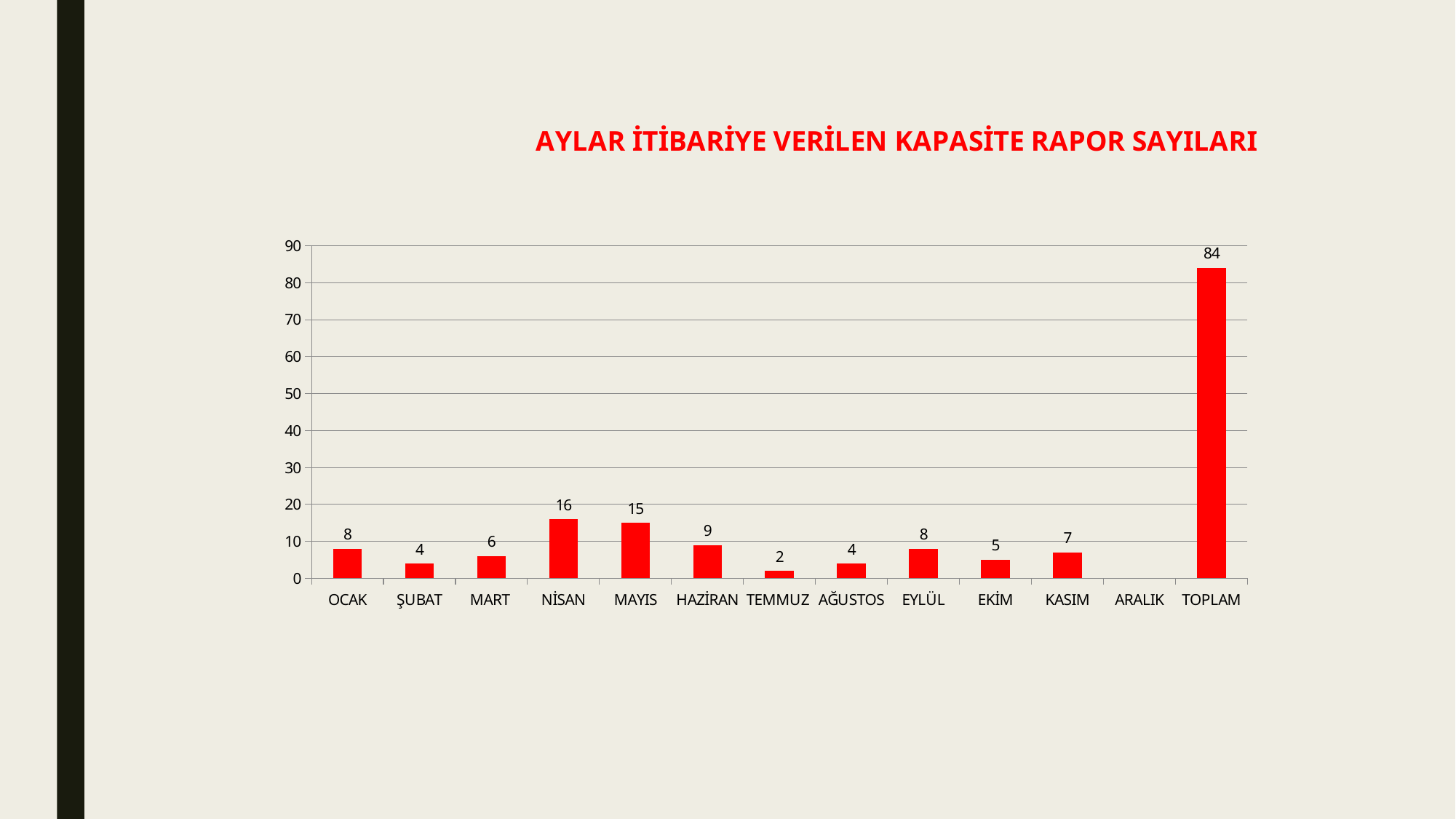
What is the difference between the values for NİSAN and MAYIS? 1 Which is larger, the value for MAYIS or the value for HAZİRAN? MAYIS Is the value for TOPLAM greater or less than 80? greater What is the value for TEMMUZ? 2 What is the value for TOPLAM? 84 Excluding TOPLAM, which month has the highest value? NİSAN Which category has the highest value? TOPLAM What kind of chart is shown on the slide? bar chart What is the value for NİSAN? 16 How many categories are labelled on the x axis? 13 Among the months with a plotted bar, which has the lowest value? TEMMUZ What is the difference between the values for TOPLAM and NİSAN? 68